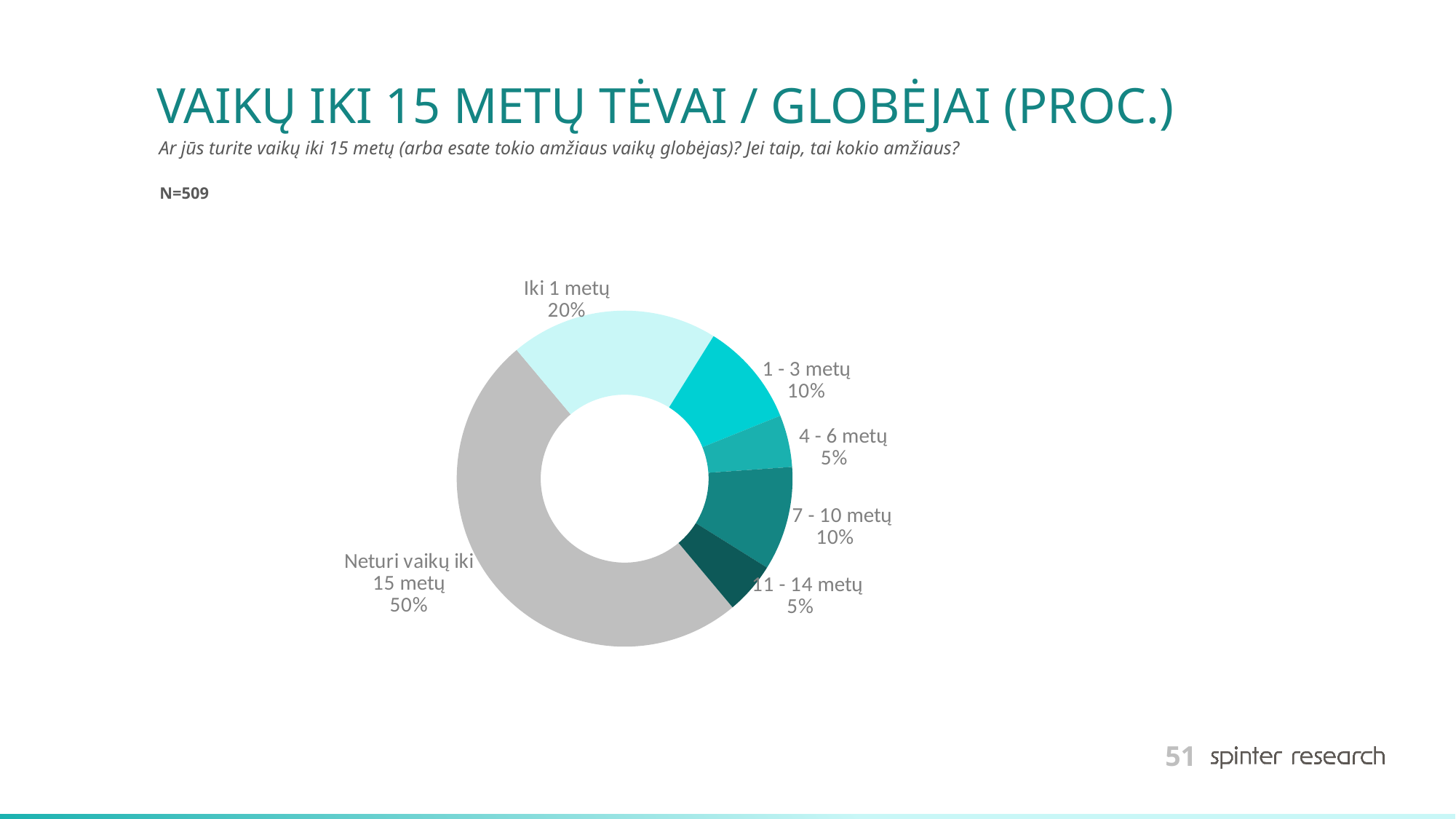
What percentage is shown for the '11 - 14 metų' category? 5% What percentage is shown for the 'Iki 1 metų' slice? 20% Which category has the largest share of the pie? Neturi vaikų iki 15 metų What share of respondents have no children under 15 (Neturi vaikų iki 15 metų)? 50% Which category has the larger share: 'Iki 1 metų' or '1 - 3 metų'? Iki 1 metų What is the sample size (N) stated on the slide? N=509 What is the title of the slide? VAIKŲ IKI 15 METŲ TĖVAI / GLOBĖJAI (PROC.) What is the difference in percentage points between 'Neturi vaikų iki 15 metų' and 'Iki 1 metų'? 30 What percentage is shown for the '7 - 10 metų' category? 10% How many categories are shown in the chart? 6 What type of chart is shown on the slide? Pie chart (doughnut) What is the combined share of the '4 - 6 metų' and '11 - 14 metų' slices? 10%